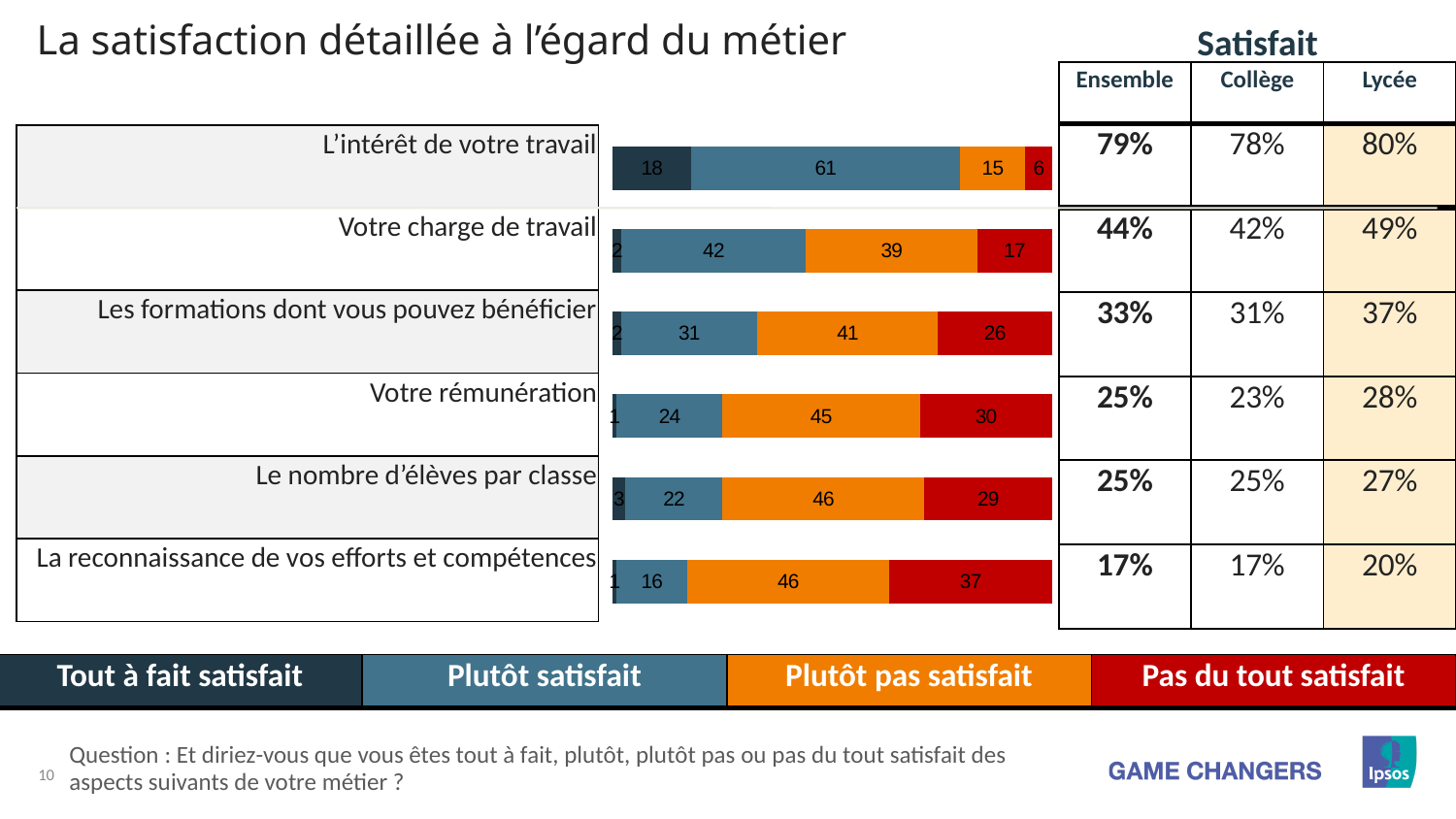
How many series does the legend list? 4 Which category has the highest "Plutôt satisfait" value? L’intérêt de votre travail What is the value of "Plutôt pas satisfait" for "Votre rémunération"? 45 Which is larger: the "Pas du tout satisfait" value for "Votre rémunération" or for "Le nombre d’élèves par classe"? Votre rémunération What kind of chart is shown on the slide? Stacked bar chart What is the value of "Plutôt satisfait" for "L’intérêt de votre travail"? 61 Which category has the highest "Pas du tout satisfait" value? La reconnaissance de vos efforts et compétences What is the value of "Pas du tout satisfait" for "La reconnaissance de vos efforts et compétences"? 37 What is the value of "Plutôt satisfait" for "Votre charge de travail"? 42 Which category has the lowest "Pas du tout satisfait" value? L’intérêt de votre travail How many categories are shown in the chart? 6 What is the difference between the "Plutôt satisfait" value for "L’intérêt de votre travail" and the "Plutôt satisfait" value for "La reconnaissance de vos efforts et compétences"? 45